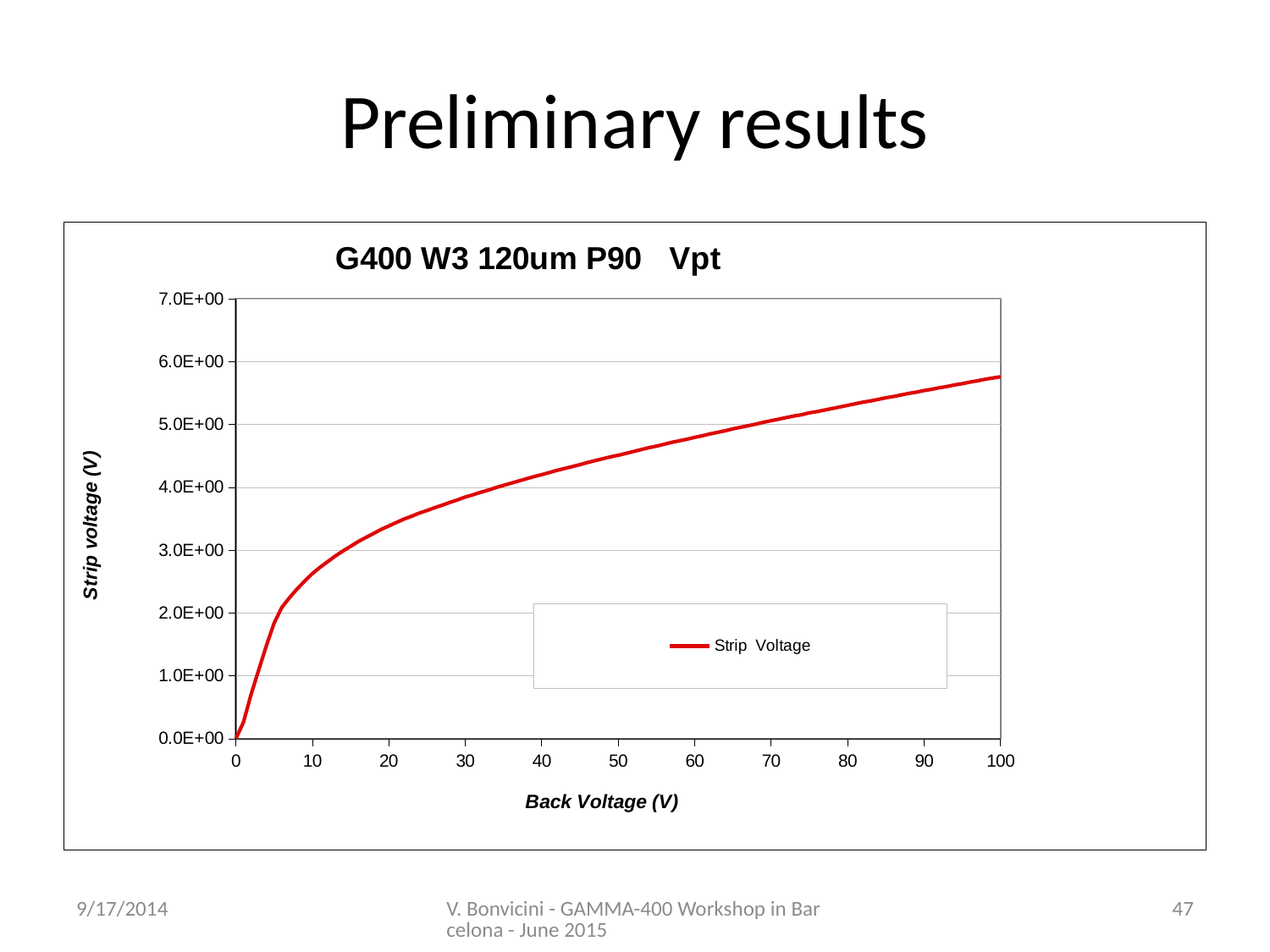
What is the title of the chart? G400 W3 120um P90 Vpt Is the strip voltage at a back voltage of 10 V greater or less than 2.0E+00? greater How many series does the legend list? 1 Is the strip voltage at a back voltage of 100 V greater or less than 6.0E+00? less Does the strip voltage rise or fall as the back voltage increases from 0 to 100 V? rise Is the strip voltage at a back voltage of 100 V greater or less than 5.0E+00? greater What is the label of the x axis? Back Voltage (V) What kind of chart is shown on the slide? line chart At which back voltage shown on the x axis is the strip voltage highest? 100